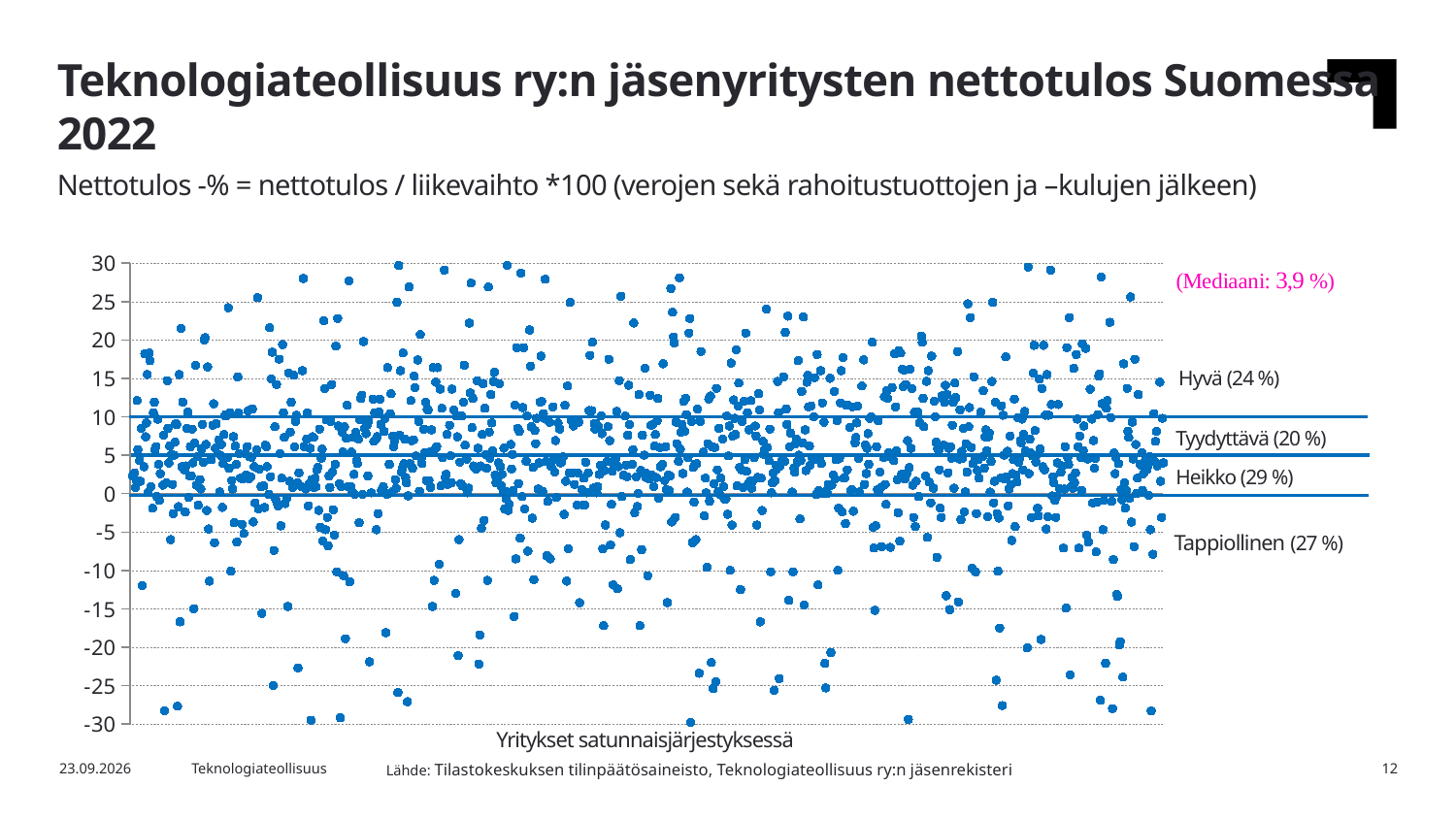
Which of the four labelled categories has the largest share of companies? Heikko How many labelled categories are shown to the right of the chart? 4 What share of companies falls into the Tappiollinen category? 27 % Which category has a larger share of companies, Tappiollinen or Hyvä? Tappiollinen Which of the four labelled categories has the smallest share of companies? Tyydyttävä What kind of chart is shown on the slide? Scatter chart What is the median net profit percentage (Mediaani) shown on the chart? 3,9 % What is the label on the x axis of the chart? Yritykset satunnaisjärjestyksessä What share of companies falls into the Hyvä category? 24 % What share of companies falls into the Tyydyttävä category? 20 % What share of companies falls into the Heikko category? 29 % How many percentage points larger is the Heikko share than the Hyvä share? 5